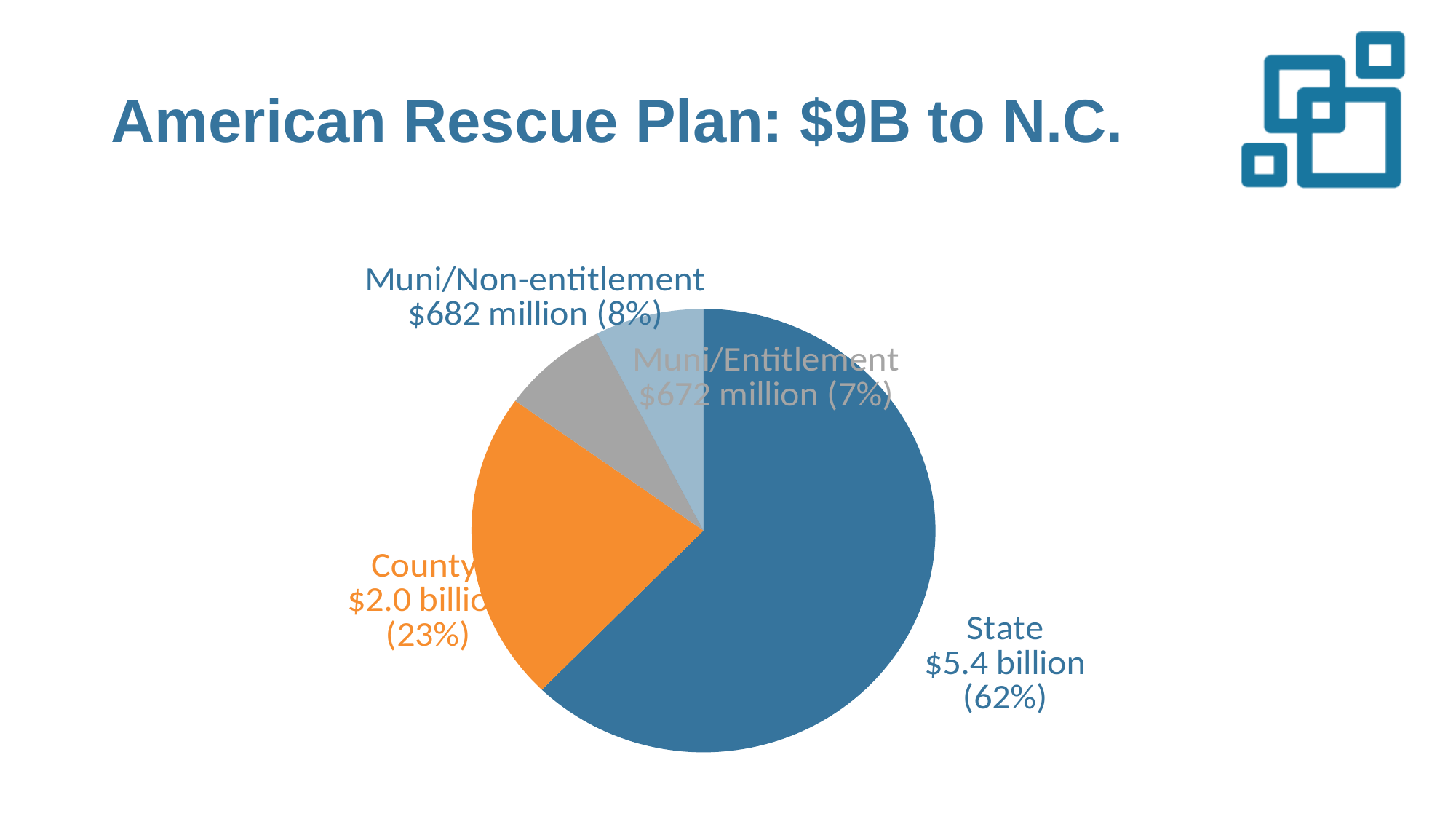
What kind of chart is shown on the slide? Pie chart What is the value shown for the State slice? $5.4 billion What is the value shown for the Muni/Non-entitlement slice? $682 million Which slice of the pie chart is the largest? State What share of the pie does the County slice represent? 23% How many slices does the pie chart have? 4 What is the difference between the Muni/Non-entitlement and Muni/Entitlement values? $10 million What share of the pie does the State slice represent? 62% What is the value shown for the Muni/Entitlement slice? $672 million What is the title of the slide containing the pie chart? American Rescue Plan: $9B to N.C. Which slice of the pie chart is the smallest? Muni/Entitlement What share of the pie does the Muni/Entitlement slice represent? 7%